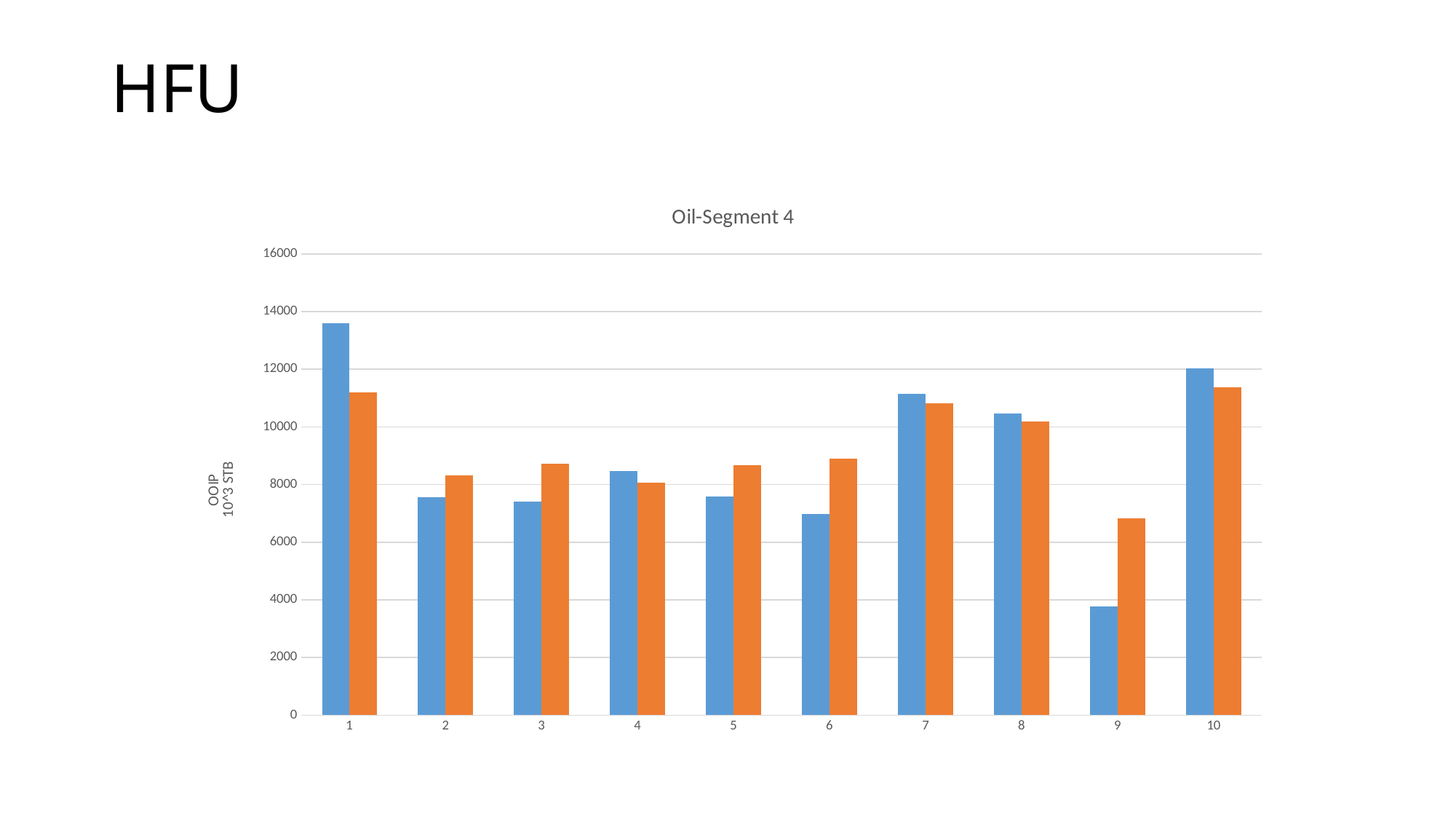
Which category has the highest blue bar? 1 Is the blue bar for category 9 greater or less than 4000? less Which category has the lowest orange bar? 9 Is the orange bar for category 6 greater or less than 8000? greater For category 1, which bar is taller, the blue or the orange? blue What type of chart is shown on the slide? bar chart For category 9, which bar is taller, the blue or the orange? orange What is the title of the chart? Oil-Segment 4 How many categories are shown on the x axis of the chart? 10 Is the blue bar for category 1 greater or less than 12000? greater Which category has the lowest blue bar? 9 What is the label of the vertical axis? OOIP 10^3 STB